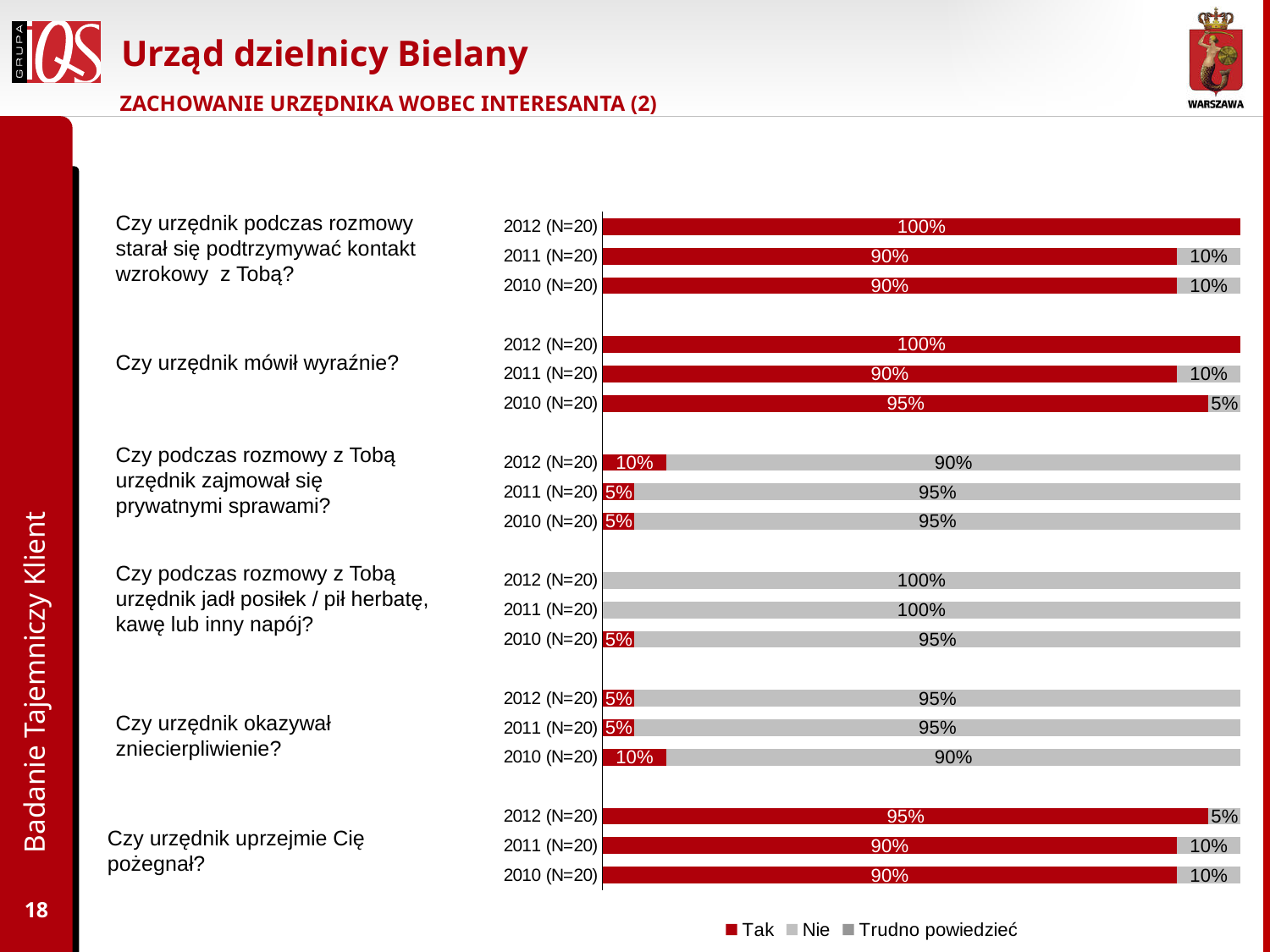
How many year rows are shown for each question in the chart? 3 For the question "Czy urzędnik uprzejmie Cię pożegnał?", what is the difference between the "Tak" values for 2012 (N=20) and 2011 (N=20)? 5% For the question "Czy urzędnik okazywał zniecierpliwienie?", which year has the highest "Tak" value? 2010 (N=20) For the question "Czy urzędnik mówił wyraźnie?", what is the "Nie" value for 2010 (N=20)? 5% For the question "Czy urzędnik mówił wyraźnie?", which year has the lowest "Tak" value? 2011 (N=20) For the question "Czy podczas rozmowy z Tobą urzędnik jadł posiłek / pił herbatę, kawę lub inny napój?", is the "Nie" value for 2010 (N=20) larger or smaller than for 2011 (N=20)? smaller What kind of chart is shown on the slide? stacked bar chart How many series does the legend list? 3 For the question "Czy urzędnik uprzejmie Cię pożegnał?", what is the "Tak" value for 2012 (N=20)? 95% What are the legend entries of the chart? Tak, Nie, Trudno powiedzieć For the question "Czy podczas rozmowy z Tobą urzędnik zajmował się prywatnymi sprawami?", what is the "Tak" value for 2012 (N=20)? 10% For the question "Czy urzędnik podczas rozmowy starał się podtrzymywać kontakt wzrokowy z Tobą?", what is the "Tak" value for 2012 (N=20)? 100%